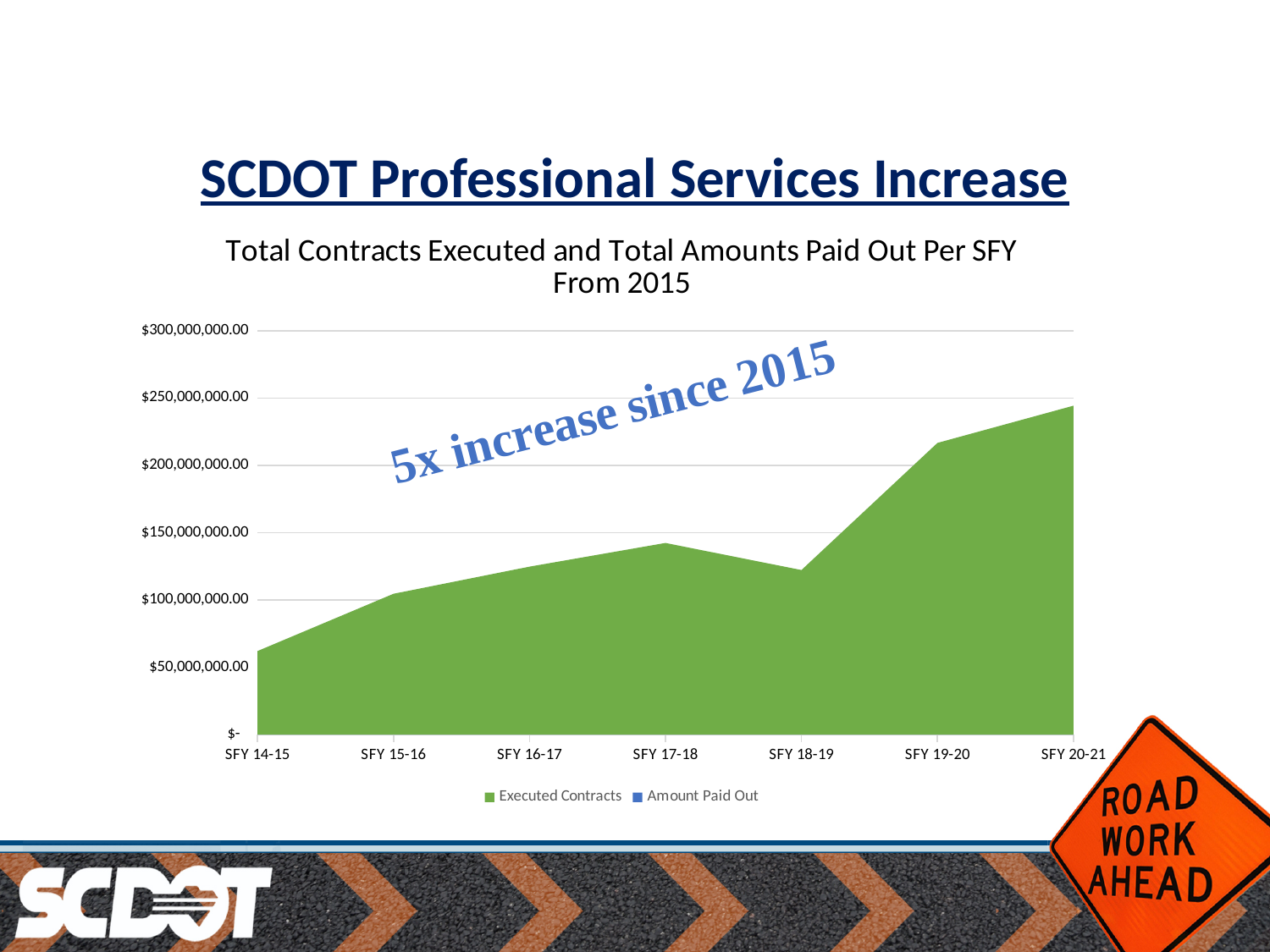
Which has the larger Executed Contracts value, SFY 17-18 or SFY 18-19? SFY 17-18 Is the Executed Contracts value for SFY 19-20 greater or less than $200,000,000.00? greater Which SFY has the highest value for Executed Contracts? SFY 20-21 What is the title of the chart? Total Contracts Executed and Total Amounts Paid Out Per SFY From 2015 Is the Executed Contracts value for SFY 18-19 greater or less than $100,000,000.00? greater What kind of chart is shown on the slide? Area chart Which SFY has the lowest value for Executed Contracts? SFY 14-15 Is the Executed Contracts value for SFY 14-15 greater or less than $100,000,000.00? less How many state fiscal years (SFY) are shown along the x axis of the chart? 7 Overall, do the Executed Contracts values rise or fall from SFY 14-15 to SFY 20-21? rise How many series does the chart's legend list? 2